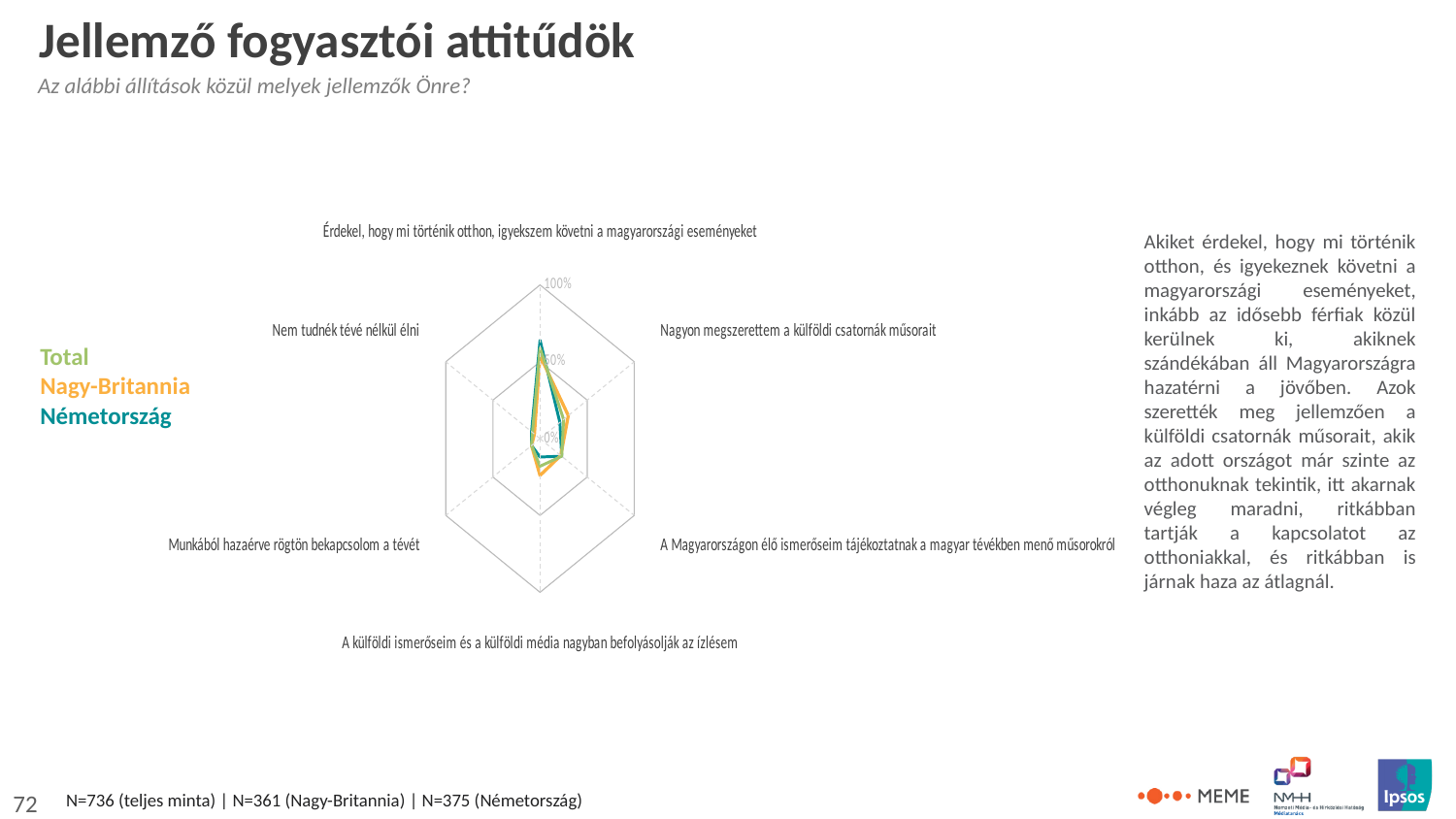
How many series does the legend of the radar chart list? 3 What is the highest percentage tick shown on the radar chart's axis? 100% Which is larger for the Total series: the value for 'Érdekel, hogy mi történik otthon, igyekszem követni a magyarországi eseményeket' or the value for 'Nem tudnék tévé nélkül élni'? Érdekel, hogy mi történik otthon, igyekszem követni a magyarországi eseményeket Is the Total value for 'Nem tudnék tévé nélkül élni' greater or less than 50%? less Is the Total value for 'Munkából hazaérve rögtön bekapcsolom a tévét' greater or less than 50%? less Is the Total value for 'Érdekel, hogy mi történik otthon, igyekszem követni a magyarországi eseményeket' greater or less than 50%? greater What kind of chart is shown on the slide? Radar chart Which statement has the highest value on the radar chart? Érdekel, hogy mi történik otthon, igyekszem követni a magyarországi eseményeket Which series are listed in the legend of the radar chart? Total, Nagy-Britannia, Németország How many statements (categories) are plotted on the radar chart? 6